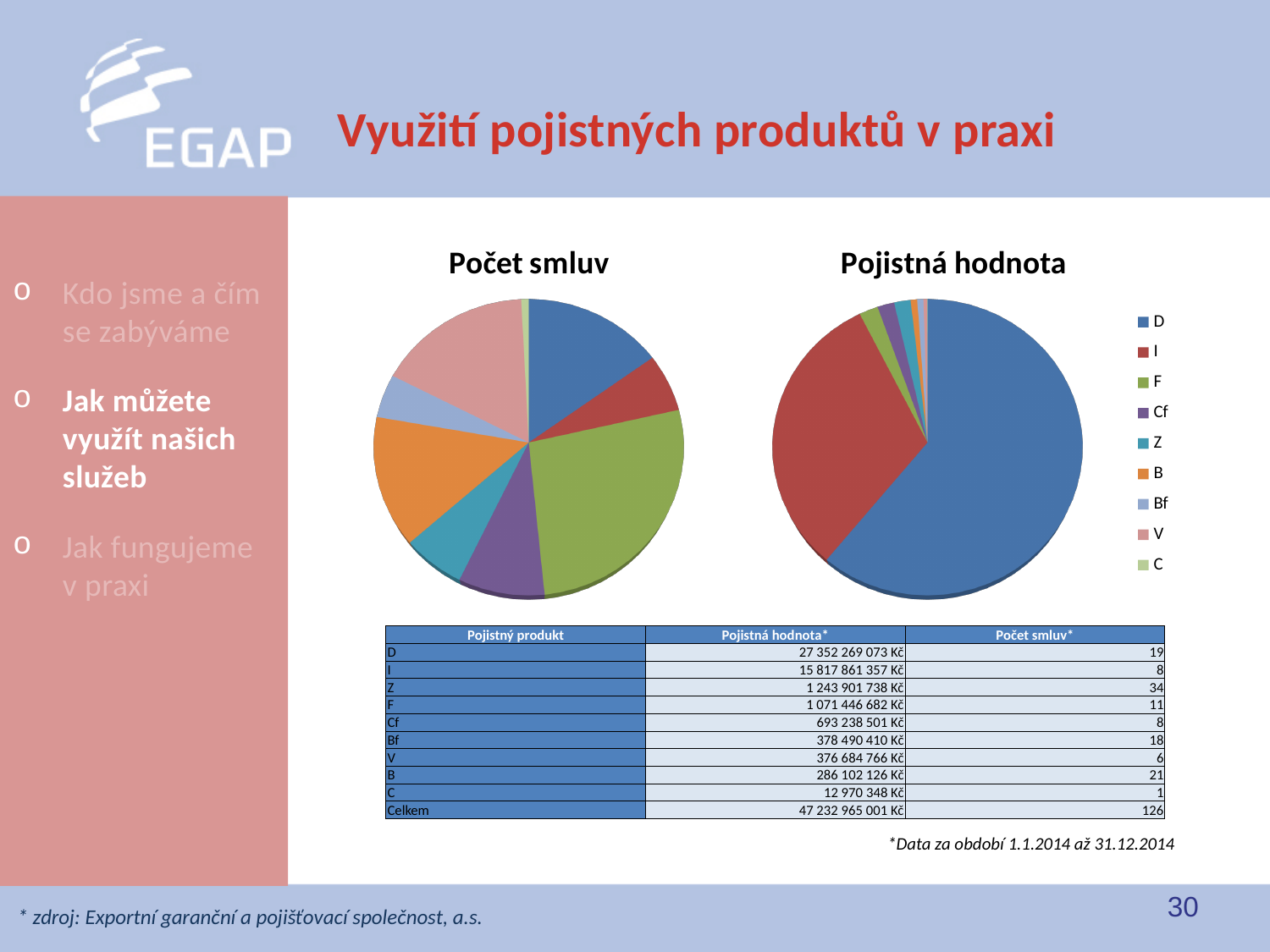
What type of chart is used for "Počet smluv"? pie chart In the "Počet smluv" chart, which product has the largest slice? Z In the "Počet smluv" chart, what is the difference between the values for Z and D? 15 How many entries does the legend list for the pie charts? 9 Which colour represents product D in the legend? blue In the "Počet smluv" chart, what is the value for Z? 34 In the "Pojistná hodnota" chart, which is larger, the slice for D or the slice for I? D In the "Počet smluv" chart, which product has the smallest slice? C What is the total number of contracts across all products in the "Počet smluv" chart? 126 In the "Pojistná hodnota" chart, what is the value for I? 15 817 861 357 Kč In the "Pojistná hodnota" chart, which product has the smallest slice? C In the "Pojistná hodnota" chart, which product has the largest slice? D